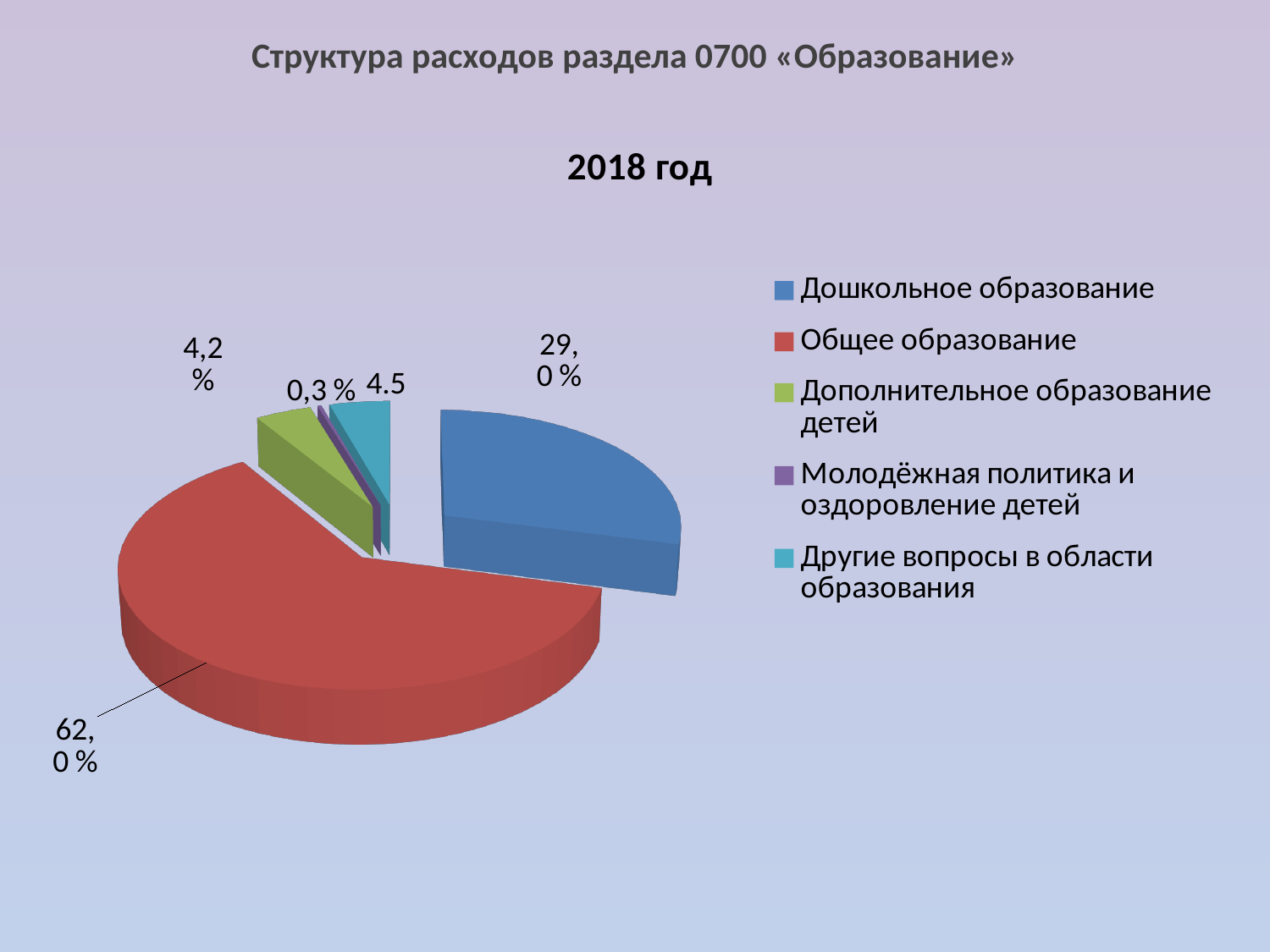
What kind of chart is shown on the slide? pie chart How many categories does the legend of the pie chart list? 5 What is the share of Общее образование in the pie chart? 62,0 % What is the share of Дошкольное образование in the pie chart? 29,0 % Which category has the smallest slice of the pie chart? Молодёжная политика и оздоровление детей What is the share of Молодёжная политика и оздоровление детей in the pie chart? 0,3 % What is the difference between the shares of Общее образование and Дошкольное образование? 33,0 % Which category has the largest slice of the pie chart? Общее образование Which is larger: the share of Дошкольное образование or the share of Дополнительное образование детей? Дошкольное образование What is the share of Дополнительное образование детей in the pie chart? 4,2 % What value is printed for Другие вопросы в области образования in the pie chart? 4.5 What is the title shown directly above the pie chart? 2018 год